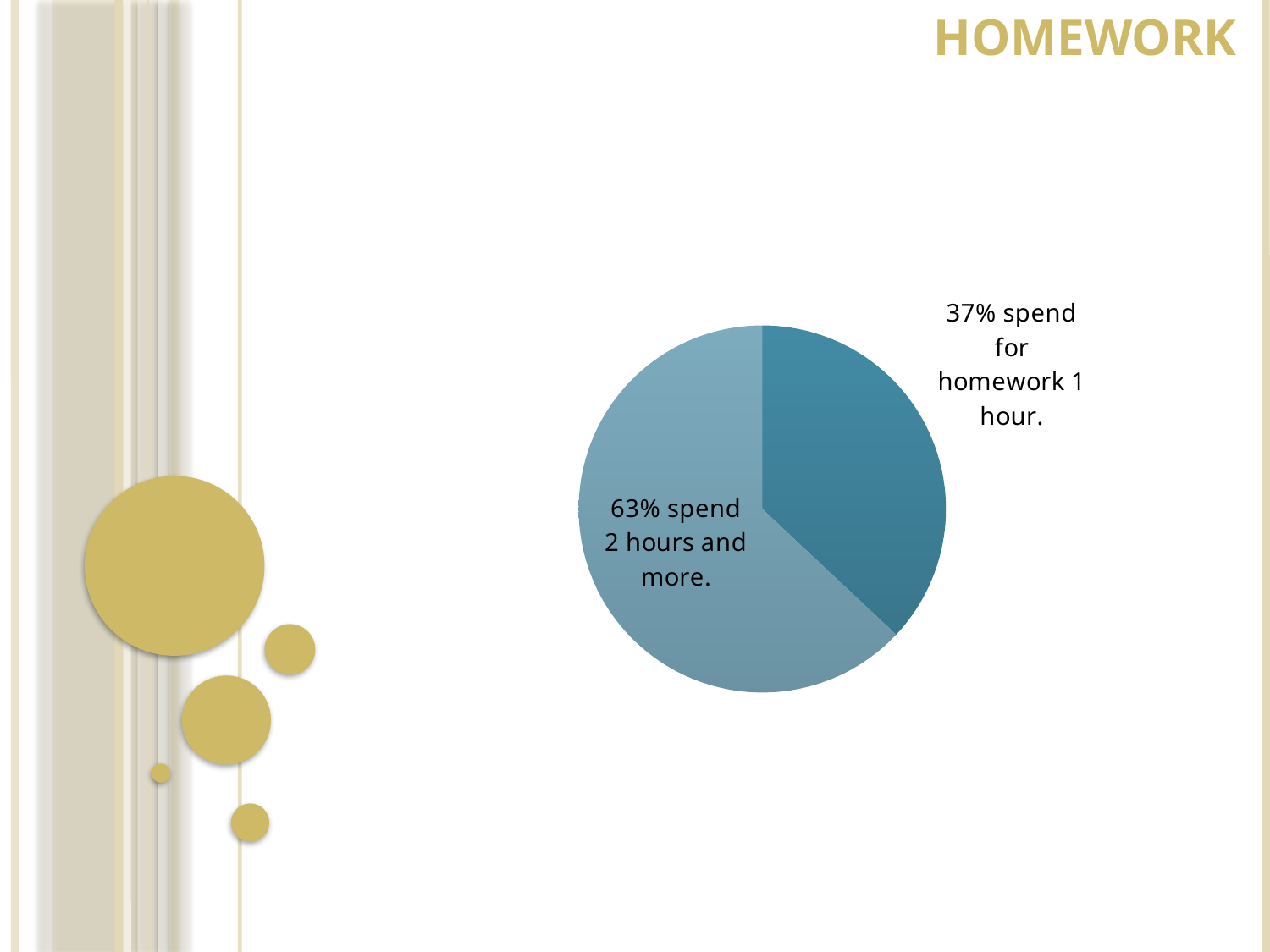
Which group is the smaller slice of the pie? 1 hour What percentage of students spend 1 hour on homework? 37% What is the title of the slide containing the pie chart? HOMEWORK Is the share of students spending 2 hours and more on homework greater or less than 50%? greater What percentage of students spend 2 hours and more on homework? 63% What is the combined share of the two slices in the pie chart? 100% What is the difference in percentage points between the share spending 2 hours and more and the share spending 1 hour? 26 What kind of chart is shown on the slide? pie chart Is the share of students spending 1 hour on homework larger or smaller than the share spending 2 hours and more? smaller Which group is the larger slice of the pie: those who spend 1 hour or those who spend 2 hours and more? 2 hours and more How many slices does the pie chart have? 2